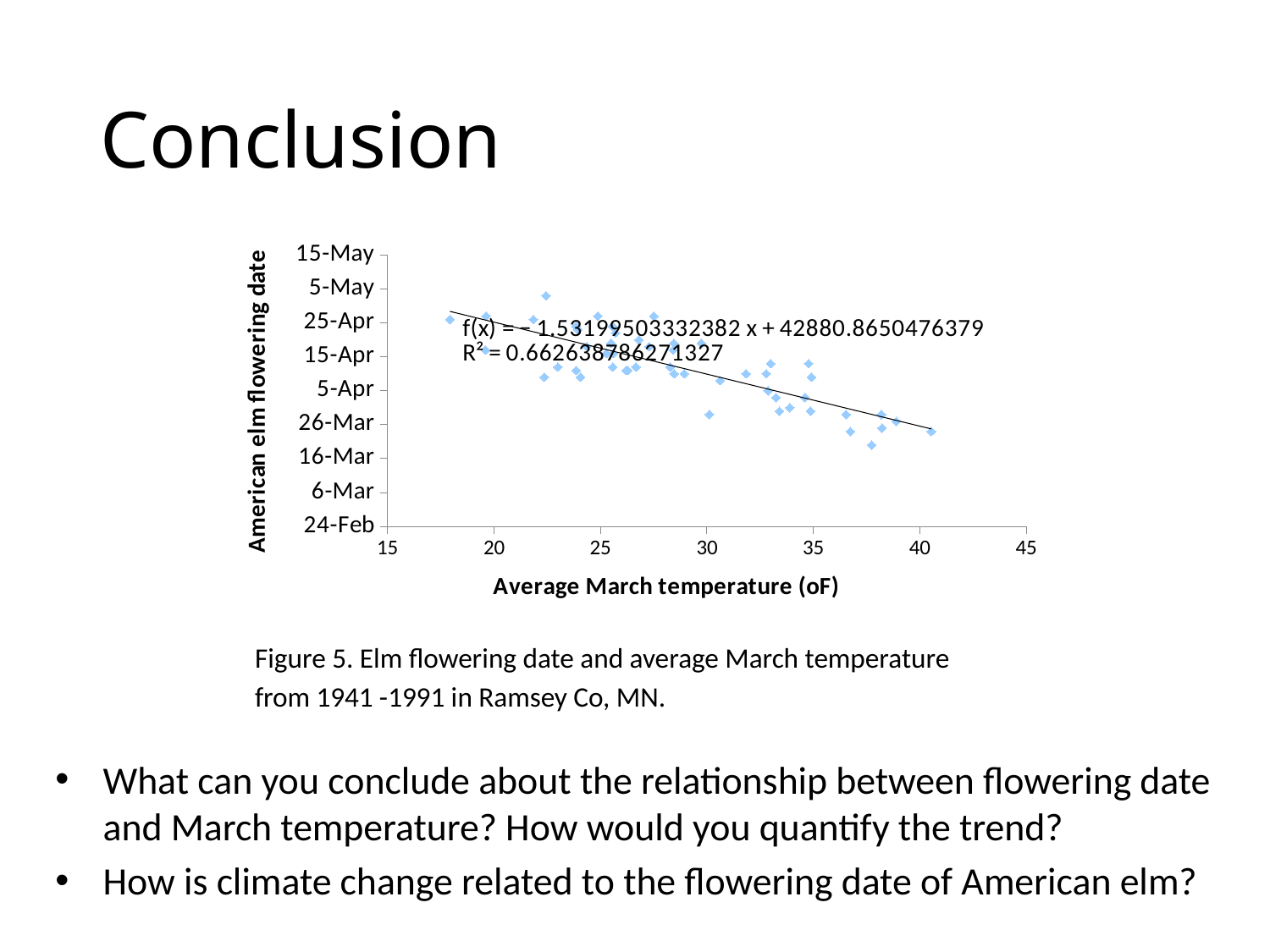
What is the topmost tick label on the y axis of the chart? 15-May As average March temperature increases along the x axis, does the elm flowering date get earlier or later? earlier What is the highest value shown on the x axis of the chart? 45 What is the slope of the trendline equation printed on the chart? -1.53199503332382 Does the trendline on the chart slope upward or downward from left to right? downward What is the lowest value shown on the x axis of the chart? 15 What kind of chart is shown on the slide? scatter chart What R² value is printed on the chart? 0.662638786271327 What is the title of the x axis of the chart? Average March temperature (oF) What is the intercept in the trendline equation printed on the chart? 42880.8650476379 What is the title of the y axis of the chart? American elm flowering date Is the latest flowering date plotted on the chart earlier or later than 25-Apr? later